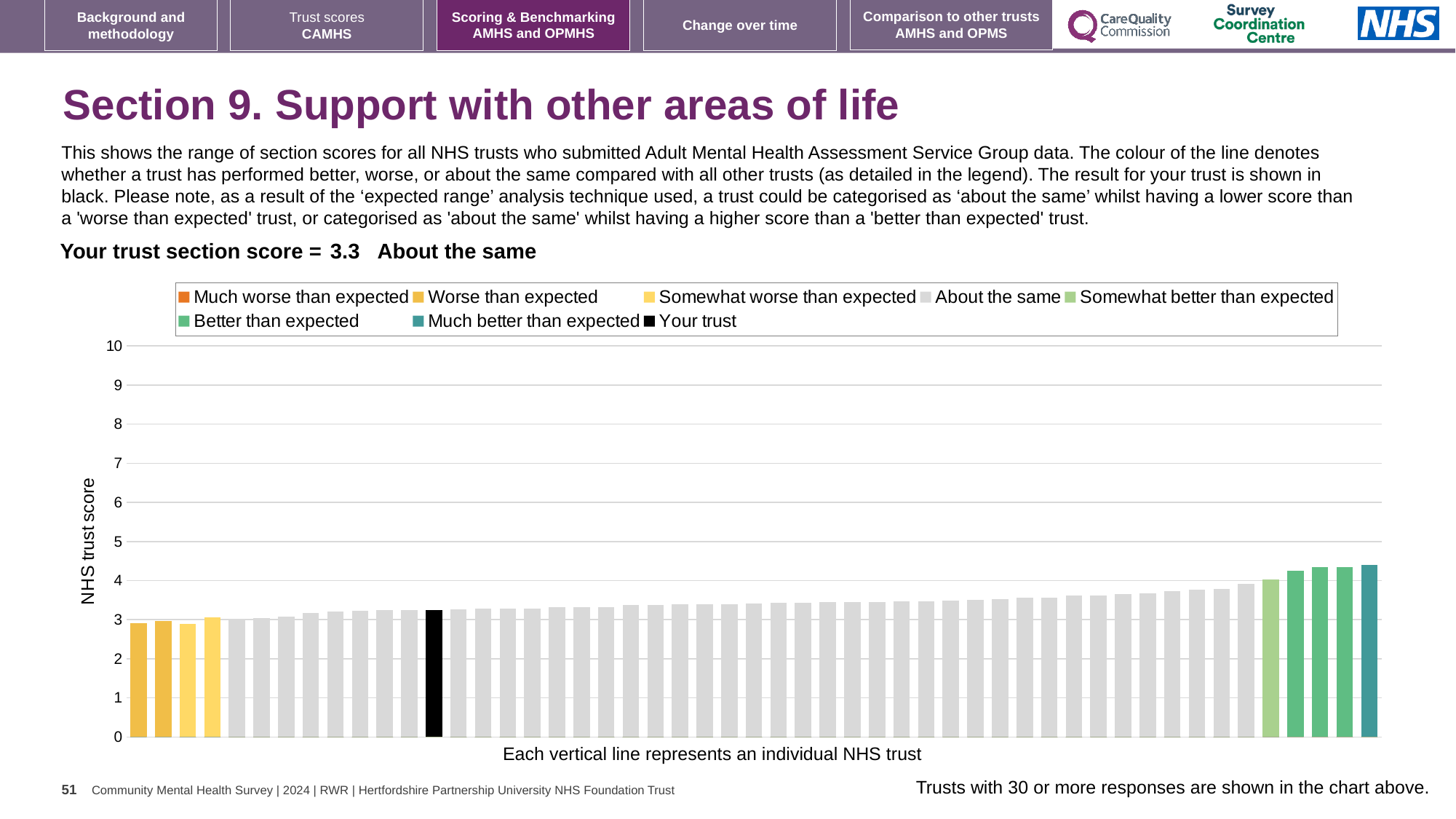
Is the bar for your trust higher or lower than the tallest bar in the chart? lower Is the value of the tallest bar greater or less than 4? greater How many entries does the chart legend list? 8 What kind of chart is shown on the slide? bar chart What is the title of the y axis? NHS trust score Is the value for your trust greater or less than 3? greater Do the bar values rise or fall from left to right along the x axis? rise Is the value of the tallest bar greater or less than 5? less How many bars are coloured as 'Better than expected'? 3 Which legend category does the tallest bar belong to? Much better than expected What is the section score for your trust shown on the slide? 3.3